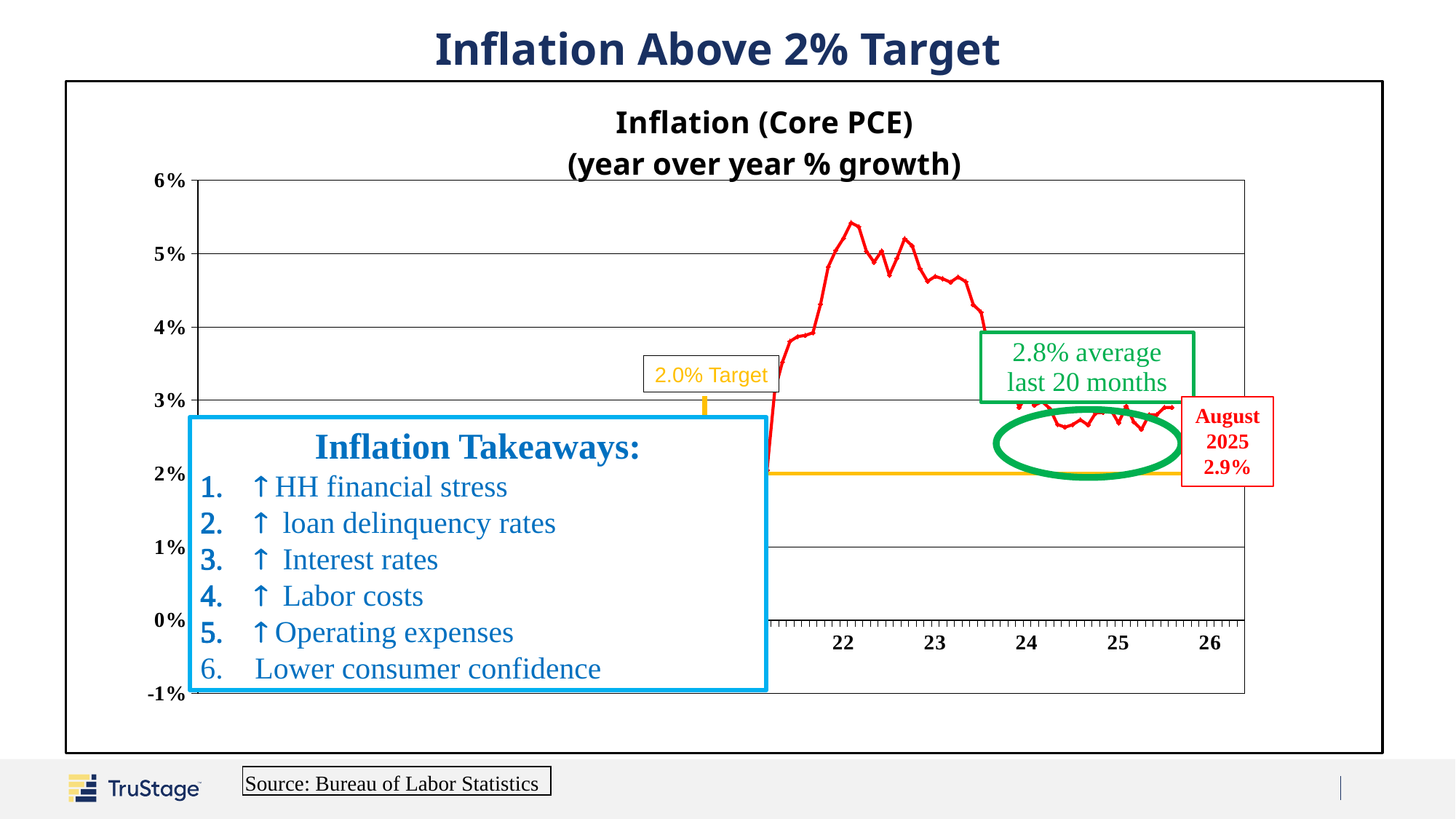
What kind of chart is shown on the slide? line chart By how many percentage points does the August 2025 value of 2.9% exceed the 2.0% target? 0.9 Is the inflation value in 2025 greater or less than 4%? less What is the title of the chart? Inflation (Core PCE) (year over year % growth) In which year on the x axis does the inflation line reach its highest point? 22 Which is larger, the August 2025 inflation value or the 2.0% target? August 2025 inflation value Does the inflation line rise or fall from its 2022 peak to 2024? fall What is the source cited for the chart data? Bureau of Labor Statistics Is the peak inflation value reached in 2022 greater or less than 5%? greater What inflation target is marked by the horizontal line on the chart? 2.0% What is the Core PCE inflation value labelled for August 2025? 2.9% What average inflation over the last 20 months is annotated on the chart? 2.8%